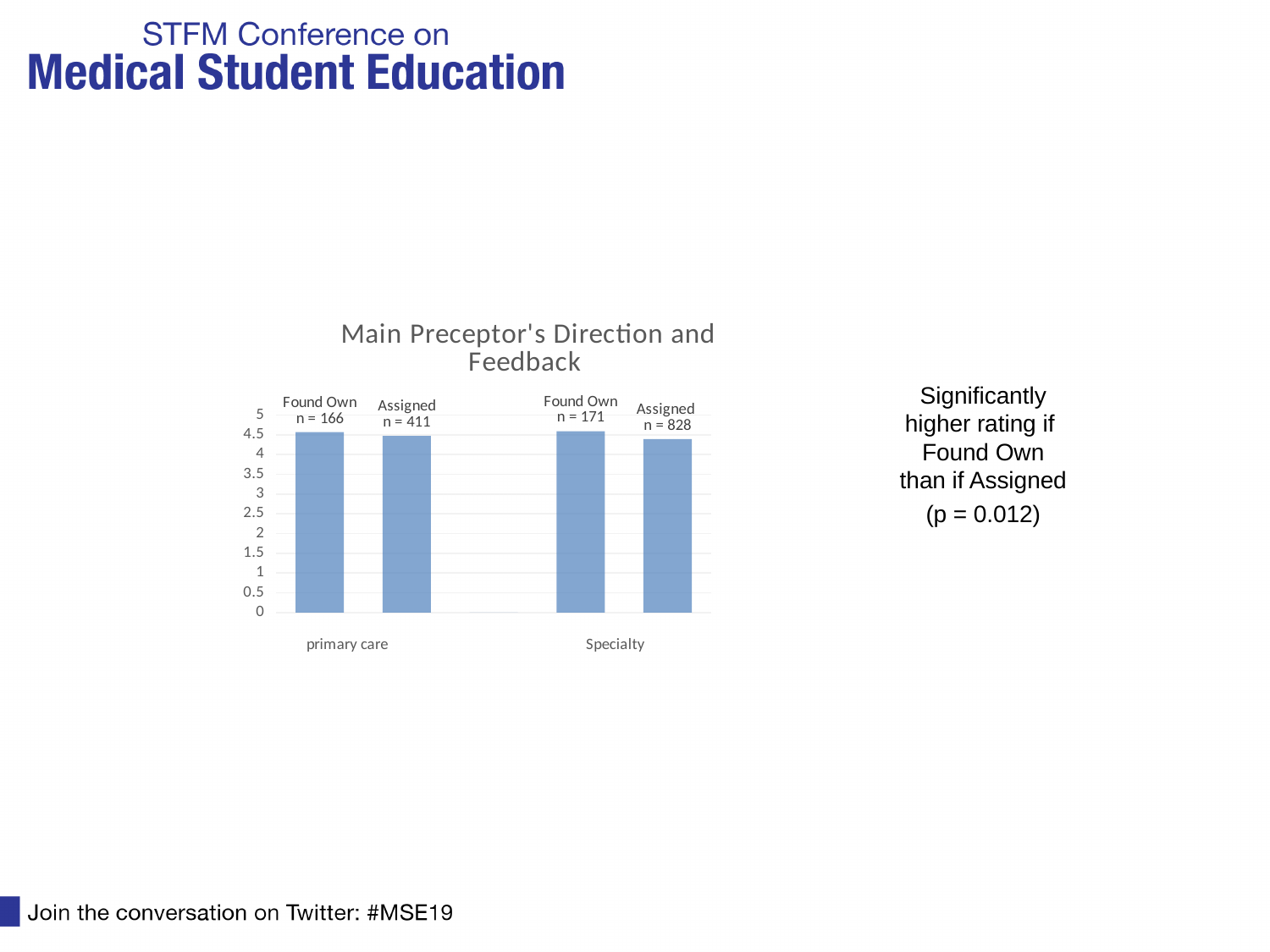
What are the two group labels shown along the x axis of the chart? primary care and Specialty What is the n value shown for the Found Own bar in the Specialty group? n = 171 Is the value for Assigned in the Specialty group greater or less than 5? less What kind of chart is shown on the slide? bar chart What is the n value shown for the Assigned bar in the Specialty group? n = 828 Is the value for Found Own in the primary care group greater or less than 4? greater What is the n value shown for the Found Own bar in the primary care group? n = 166 Is the value for Assigned in the Specialty group greater or less than 4.5? less In the Specialty group, which bar is taller, Found Own or Assigned? Found Own What is the n value shown for the Assigned bar in the primary care group? n = 411 How many bars are plotted in the chart? 4 What is the title of the chart? Main Preceptor's Direction and Feedback